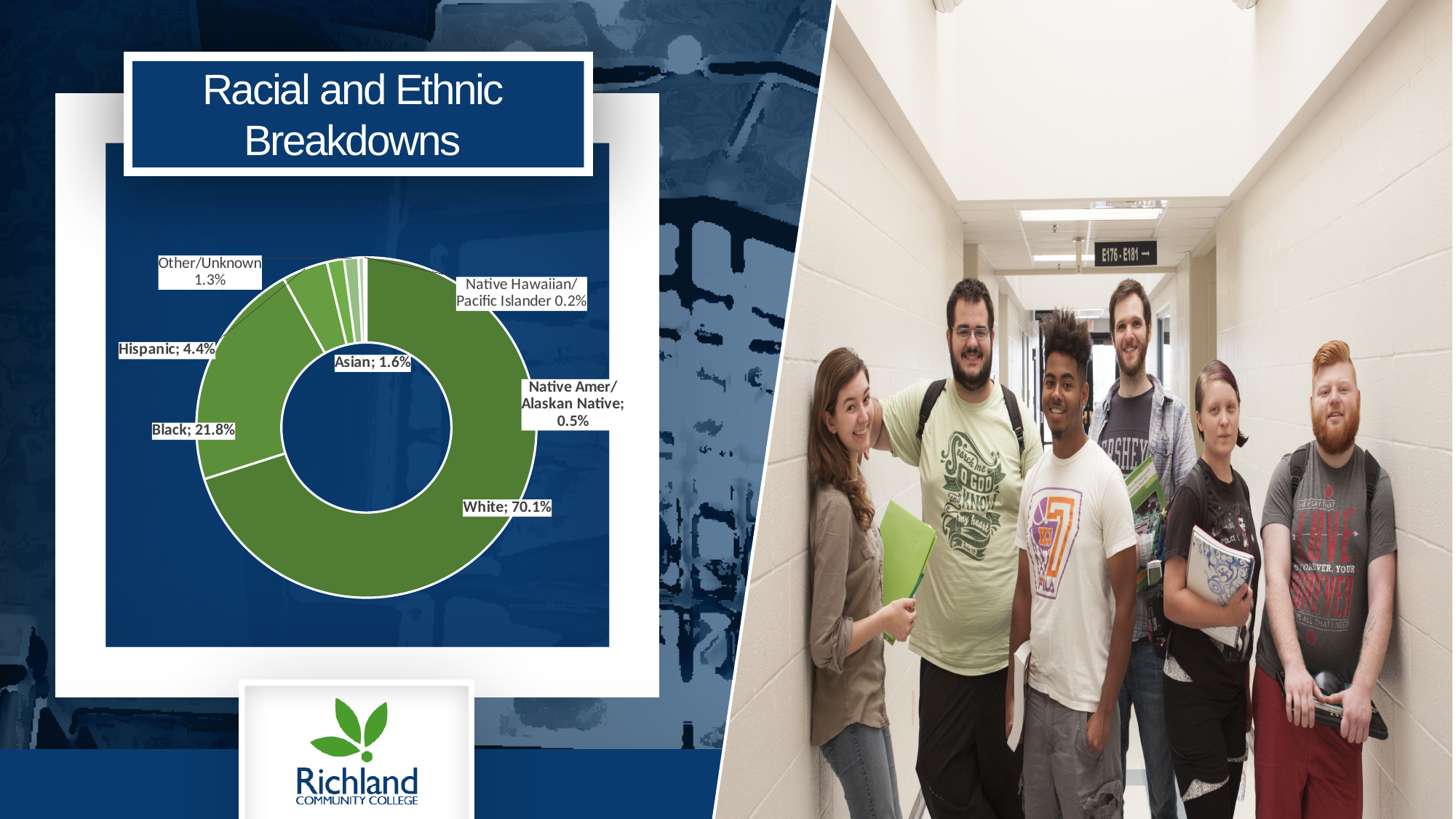
What percentage is shown for Hispanic? 4.4% Which category has the smallest share of the chart? Native Hawaiian/Pacific Islander What type of chart is shown on the slide? doughnut chart What is the difference in percentage points between White and Black? 48.3 Which is larger, the share for Hispanic or the share for Other/Unknown? Hispanic What percentage is shown for Asian? 1.6% What percentage is shown for Native Hawaiian/Pacific Islander? 0.2% Which category has the largest share of the chart? White What is the title of the chart? Racial and Ethnic Breakdowns How many categories are shown in the chart? 7 What percentage of the breakdown is Black? 21.8% What percentage of the breakdown is White? 70.1%